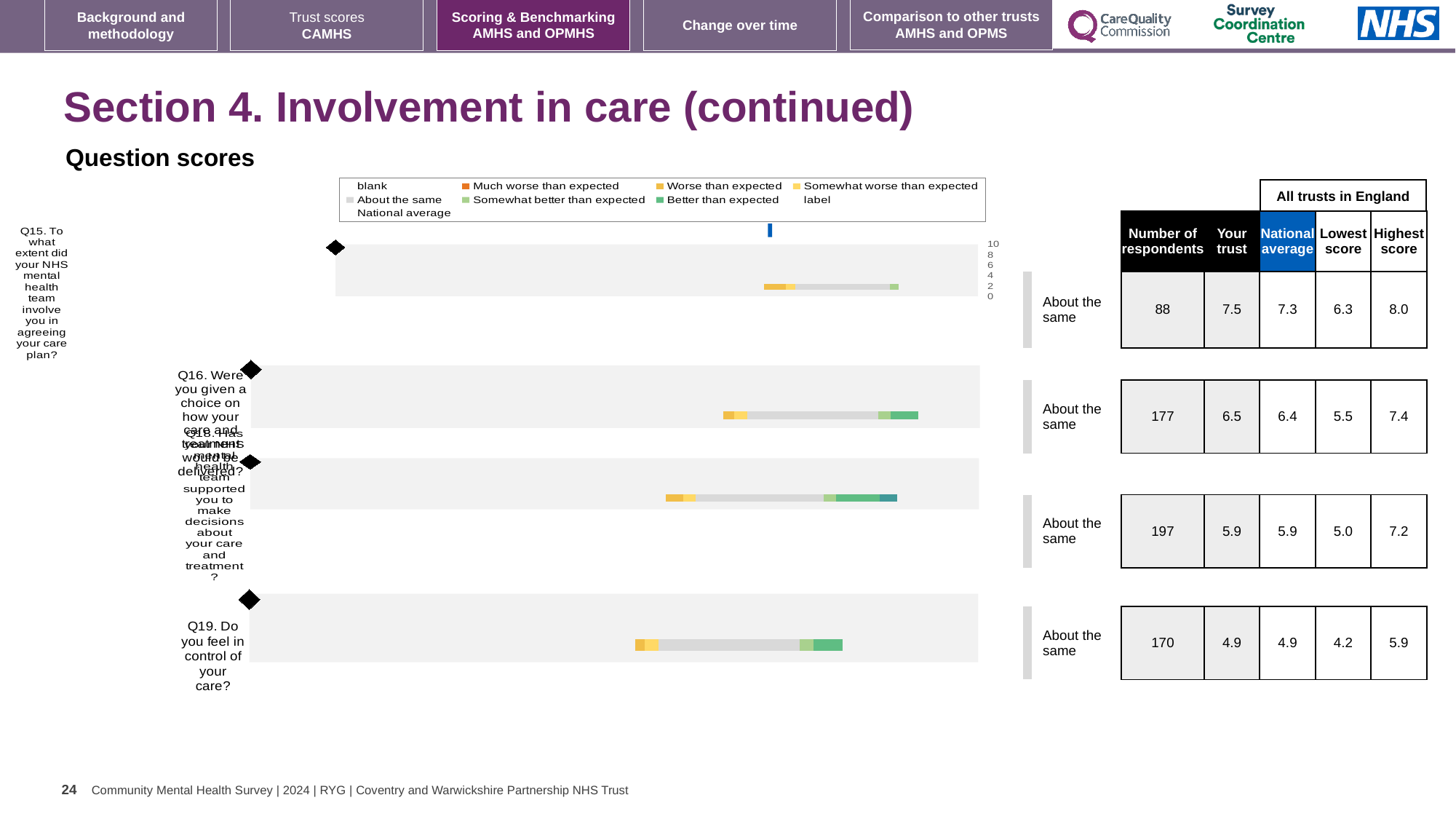
In the table beside the Q15 bar, what is the 'Your trust' score? 7.5 Which question has the highest 'Your trust' score on this slide? Q15 For Q16, which is larger: the 'Your trust' score or the national average? Your trust How many questions (Q15, Q16, Q18, Q19) have a score bar on this slide? 4 For Q15, what is the difference between the highest score (8.0) and the lowest score (6.3) among all trusts in England? 1.7 How many respondents are listed for Q18 (supported to make decisions about your care and treatment)? 197 In the table beside the Q16 bar, what is the national average score? 6.4 What benchmark category label is shown next to the Q15 bar? About the same What is the highest score among all trusts in England for Q19 (Do you feel in control of your care)? 5.9 In the legend, what colour represents 'Much worse than expected'? orange Which question has the lowest 'Your trust' score on this slide? Q19 What kind of chart is used to show the question scores on this slide? bar chart